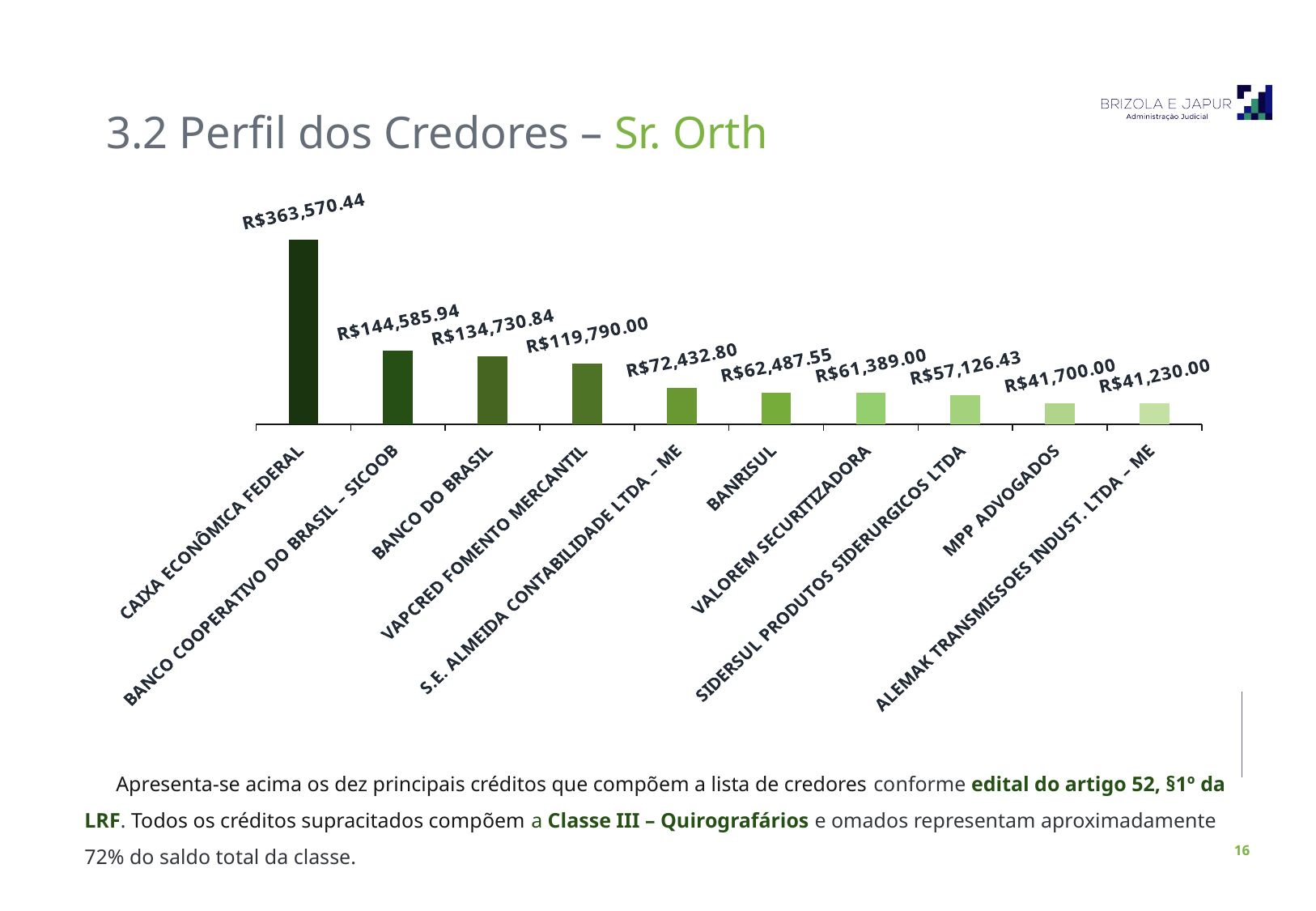
What is the value for MPP ADVOGADOS? R$41,700.00 Which creditor has the lowest value? ALEMAK TRANSMISSOES INDUST. LTDA – ME How many creditors are shown in the chart? 10 Which creditor has the highest value? CAIXA ECONÔMICA FEDERAL What is the difference between the values for CAIXA ECONÔMICA FEDERAL and BANCO COOPERATIVO DO BRASIL – SICOOB? R$218,984.50 What kind of chart is shown on the slide? Bar chart Do the values rise or fall from left to right along the x axis? Fall What is the value for BANRISUL? R$62,487.55 What is the value for BANCO DO BRASIL? R$134,730.84 Which is larger, the value for VAPCRED FOMENTO MERCANTIL or the value for S.E. ALMEIDA CONTABILIDADE LTDA – ME? VAPCRED FOMENTO MERCANTIL What is the value for CAIXA ECONÔMICA FEDERAL? R$363,570.44 What is the difference between the values for MPP ADVOGADOS and ALEMAK TRANSMISSOES INDUST. LTDA – ME? R$470.00